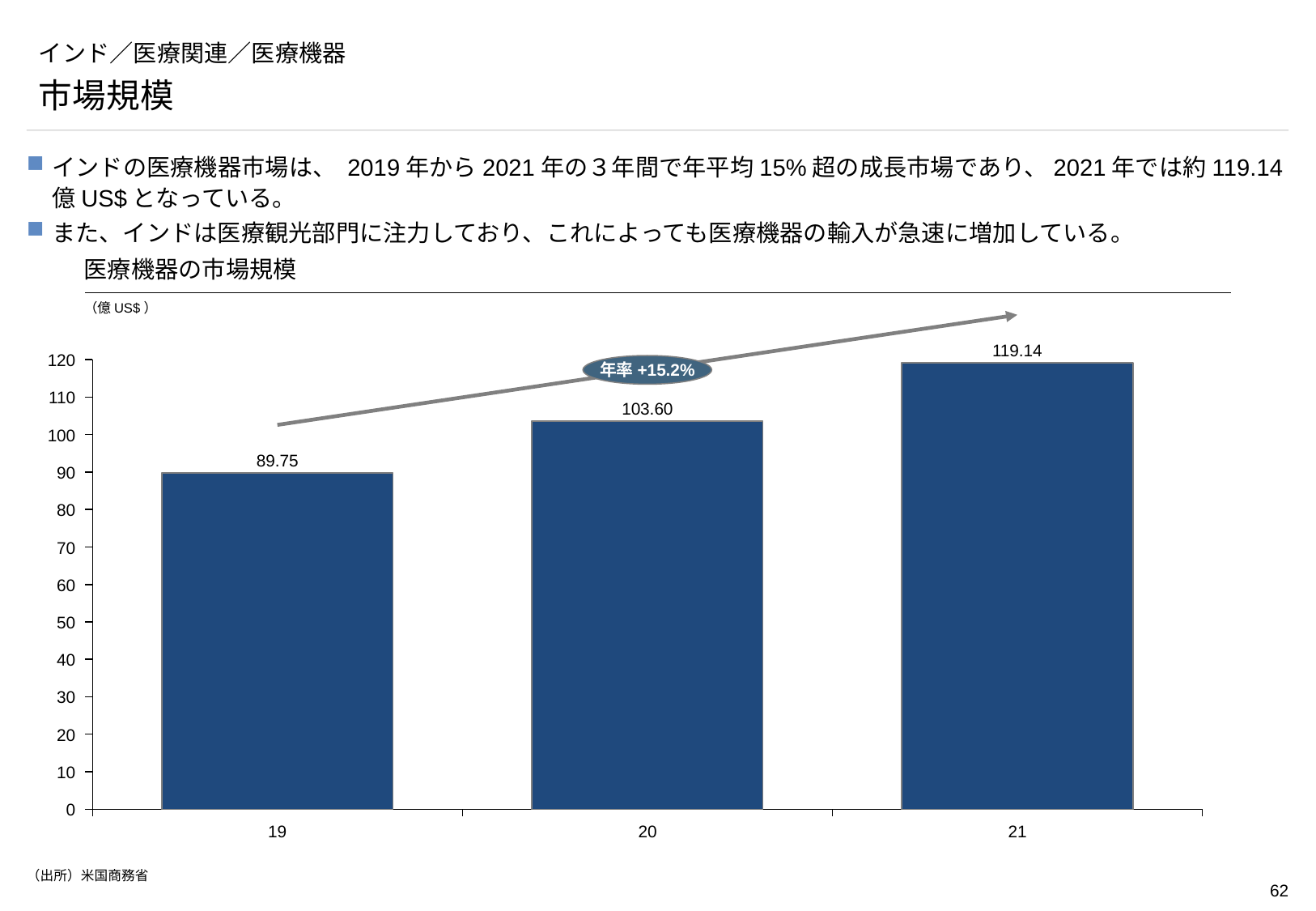
Which is larger, the value for 20 or the value for 21? 21 What is the value for 20 in the 医療機器の市場規模 chart? 103.60 Which year has the highest value in the chart? 21 What is the value for 19 in the 医療機器の市場規模 chart? 89.75 How many years are shown on the x axis of the chart? 3 What is the difference between the values for 20 and 19? 13.85 Do the values rise or fall from 19 to 21? rise Which year has the lowest value in the chart? 19 What kind of chart is shown on the slide? bar chart Is the value for 20 greater or less than 100? greater What is the difference between the values for 21 and 19? 29.39 What is the value for 21 in the 医療機器の市場規模 chart? 119.14